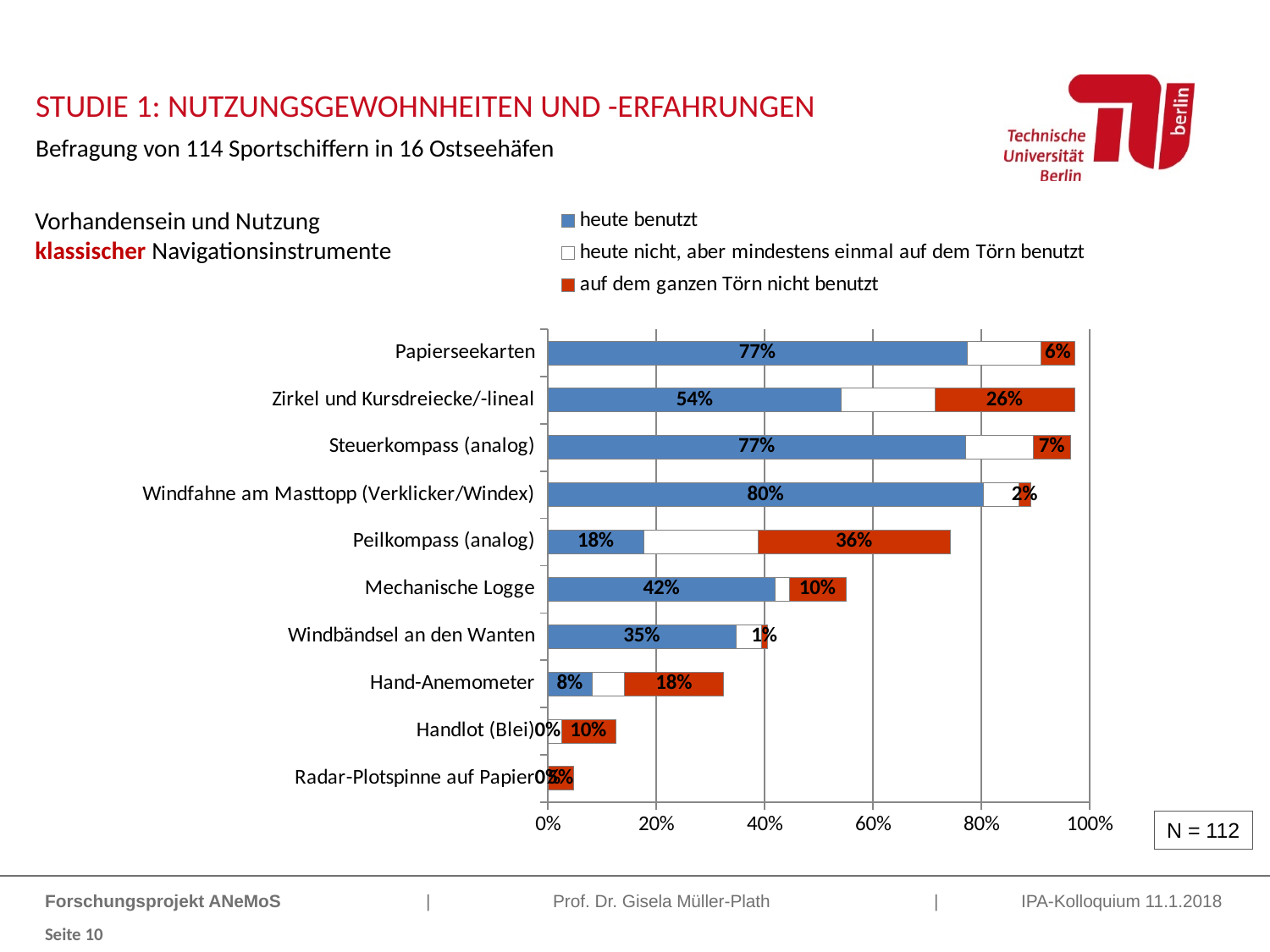
How many navigation instruments are listed on the chart? 10 Which instrument has the highest "heute benutzt" percentage? Windfahne am Masttopp (Verklicker/Windex) What is the "auf dem ganzen Törn nicht benutzt" value for Hand-Anemometer? 18% Is the total bar length for Peilkompass (analog) greater or less than 60%? greater Which has a larger "heute benutzt" value: Mechanische Logge or Windbändsel an den Wanten? Mechanische Logge Which instrument has the highest "auf dem ganzen Törn nicht benutzt" percentage? Peilkompass (analog) How many series does the legend list? 3 What is the difference between the "heute benutzt" values for Zirkel und Kursdreiecke/-lineal and Peilkompass (analog)? 36 percentage points What percentage of respondents use Papierseekarten today ("heute benutzt")? 77% What is the "auf dem ganzen Törn nicht benutzt" value for Zirkel und Kursdreiecke/-lineal? 26% What kind of chart is shown on the slide? Stacked bar chart What is the "heute benutzt" value for Peilkompass (analog)? 18%